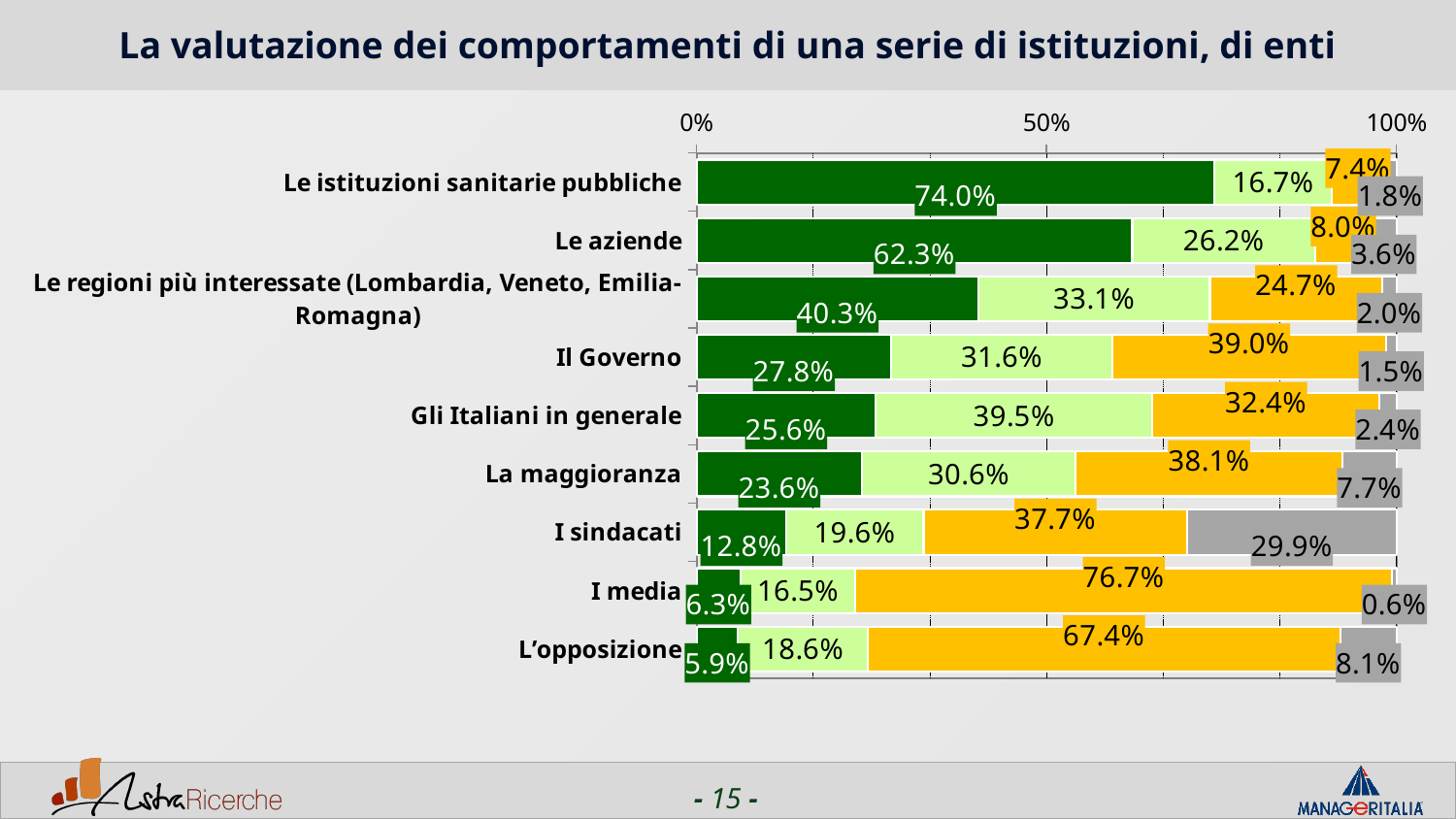
What type of chart is shown on the slide? Stacked bar chart Is the dark green value for 'Le aziende' greater or less than 50%? greater What is the value of the dark green segment for 'Le istituzioni sanitarie pubbliche'? 74.0% Which category has the largest dark green segment? Le istituzioni sanitarie pubbliche How many institutions or entities are listed as categories in the chart? 9 What is the value of the light green segment for 'Gli Italiani in generale'? 39.5% What is the value of the gray segment for 'I sindacati'? 29.9% Which has a larger gray segment, 'I sindacati' or 'L’opposizione'? I sindacati What is the value of the orange segment for 'I media'? 76.7% What is the total of the four segments in the 'I sindacati' bar? 100.0% Which category has the smallest dark green segment? L’opposizione What is the difference between the dark green values for 'Le istituzioni sanitarie pubbliche' and 'Le aziende'? 11.7 percentage points